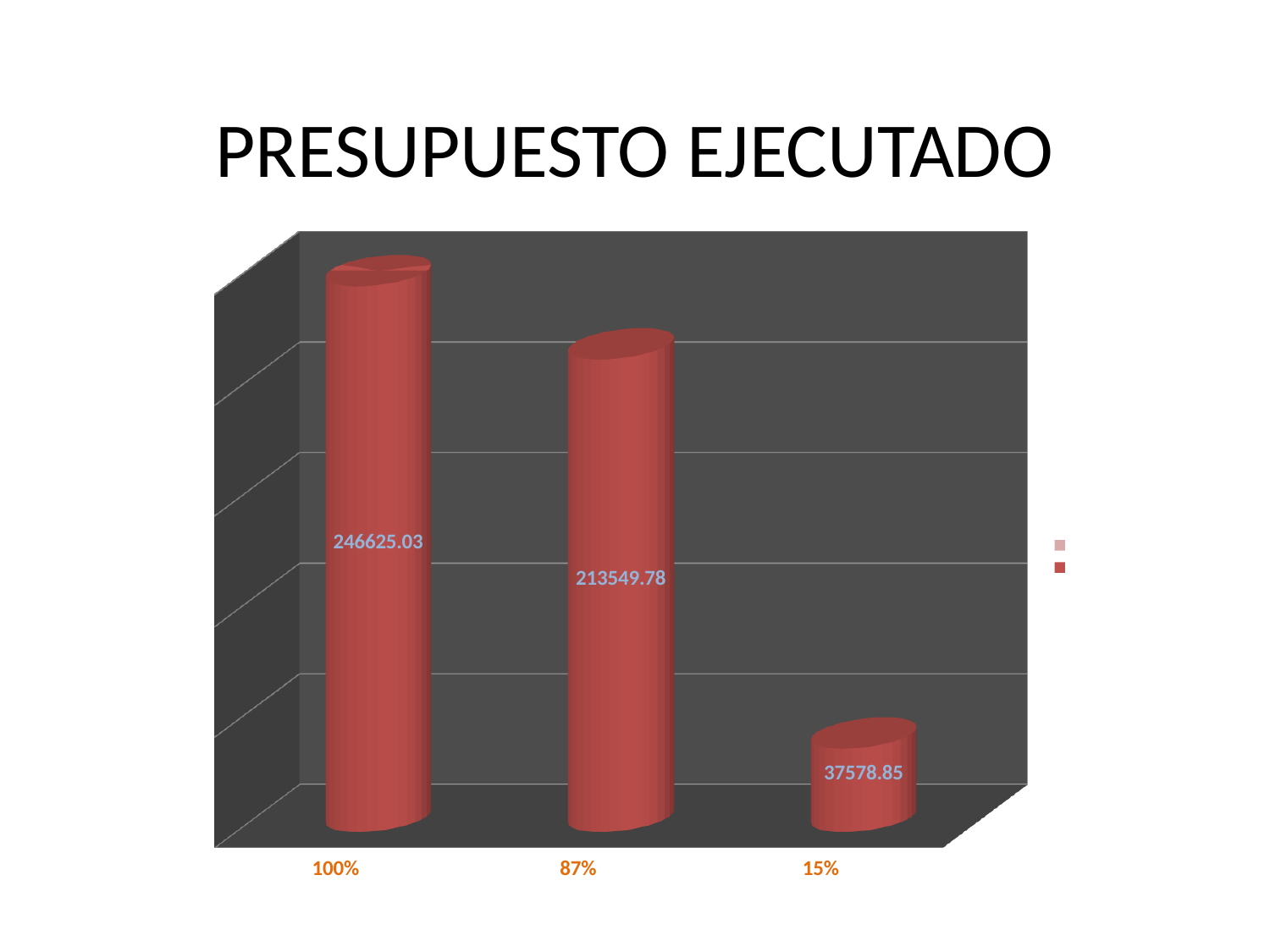
What is the title of the slide? PRESUPUESTO EJECUTADO What is the difference between the values for 87% and 15%? 175970.93 Which category has the highest value? 100% Which is larger, the value for 87% or the value for 15%? 87% What is the value of the bar labelled 87%? 213549.78 Which category has the lowest value? 15% What is the difference between the values for 100% and 87%? 33075.25 What kind of chart is shown on the slide? Bar chart What is the value of the bar labelled 15%? 37578.85 Do the values rise or fall from left to right along the x axis? Fall What is the value of the bar labelled 100%? 246625.03 How many bars are shown in the chart? 3